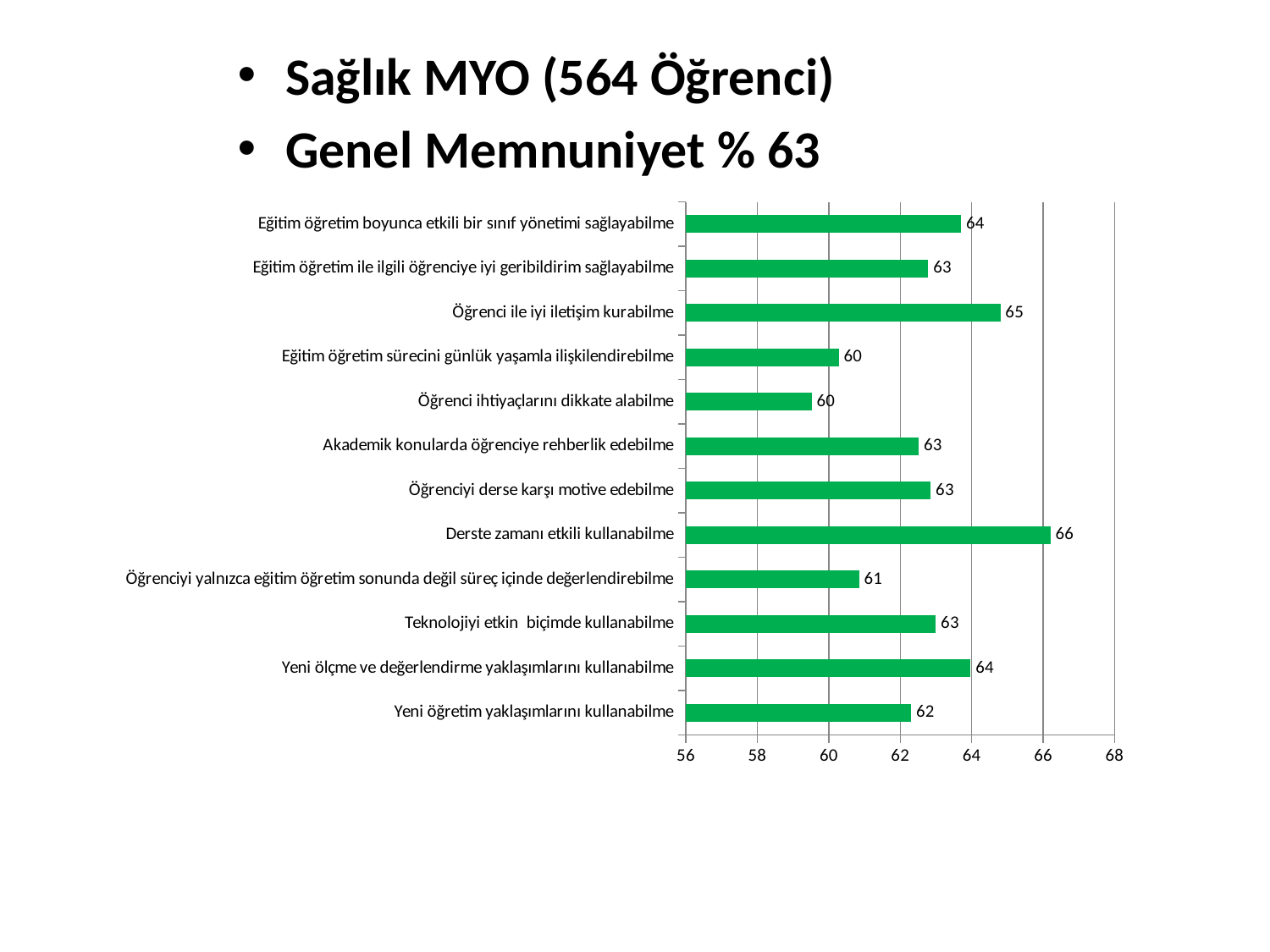
What is the difference between the values for "Derste zamanı etkili kullanabilme" and "Öğrenci ihtiyaçlarını dikkate alabilme"? 6 How many categories are shown in the chart? 12 Is the value for "Öğrenci ihtiyaçlarını dikkate alabilme" greater or less than 62? less What is the value for "Öğrenci ile iyi iletişim kurabilme"? 65 What is the value for "Öğrenciyi yalnızca eğitim öğretim sonunda değil süreç içinde değerlendirebilme"? 61 What is the value for "Yeni öğretim yaklaşımlarını kullanabilme"? 62 Which category has the highest value? Derste zamanı etkili kullanabilme Is the value for "Derste zamanı etkili kullanabilme" greater or less than 64? greater Which is larger, the value for "Öğrenci ile iyi iletişim kurabilme" or for "Yeni öğretim yaklaşımlarını kullanabilme"? Öğrenci ile iyi iletişim kurabilme What is the value for "Derste zamanı etkili kullanabilme"? 66 What colour are the bars in the chart? green What kind of chart is shown on the slide? bar chart